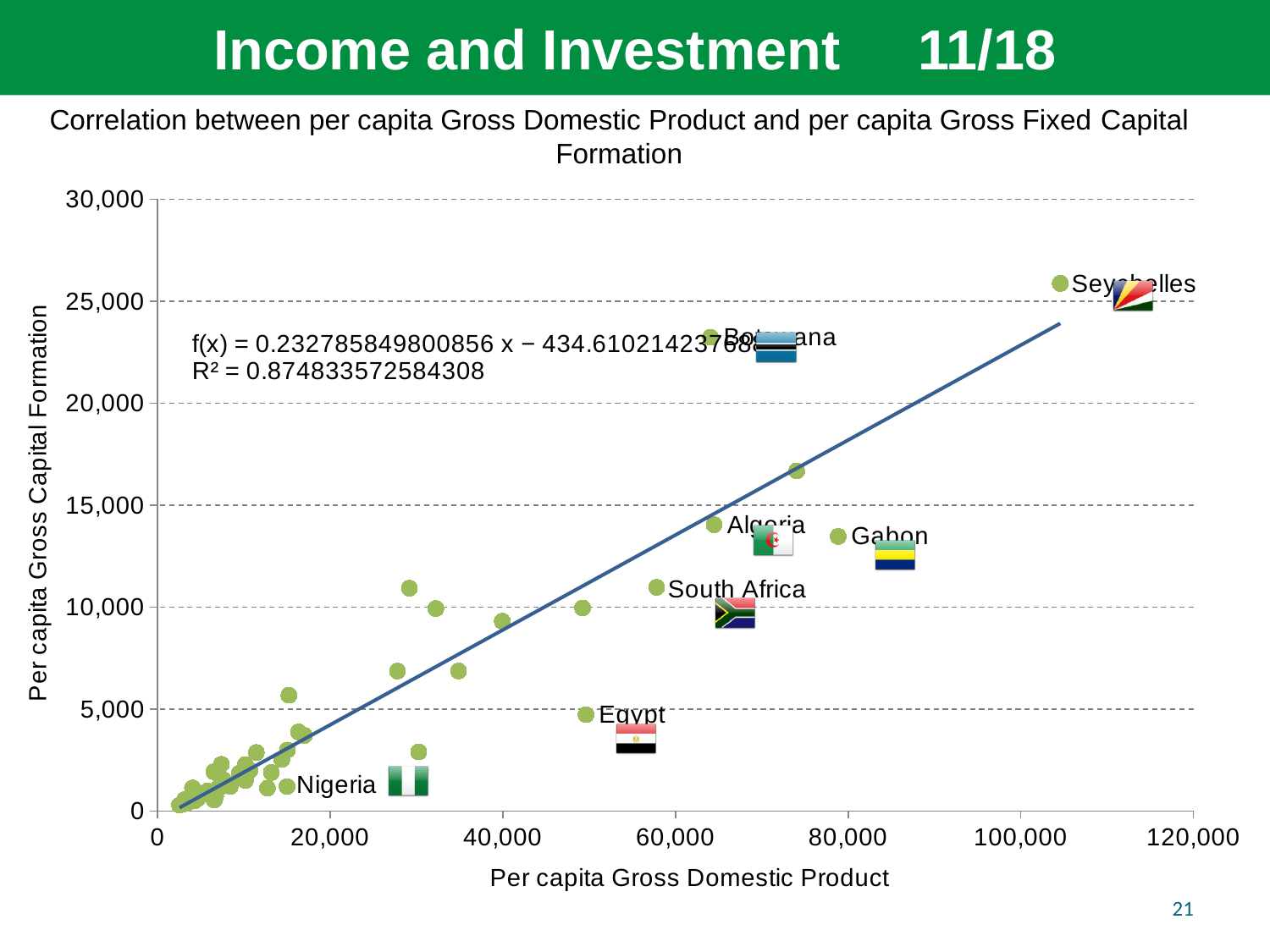
What is the R² value shown on the chart? 0.874833572584308 Is the per capita Gross Fixed Capital Formation for Seychelles greater or less than 25,000? greater Which labelled country has the lowest per capita Gross Fixed Capital Formation? Nigeria What is the title of the x axis? Per capita Gross Domestic Product Is the per capita Gross Fixed Capital Formation for Nigeria greater or less than 5,000? less Is the per capita Gross Fixed Capital Formation for Botswana greater or less than 20,000? greater Which labelled country has the highest per capita Gross Fixed Capital Formation? Seychelles What kind of chart is shown on the slide? scatter chart Which has the higher per capita Gross Fixed Capital Formation, Botswana or Algeria? Botswana Which has the higher per capita Gross Domestic Product, Gabon or South Africa? Gabon